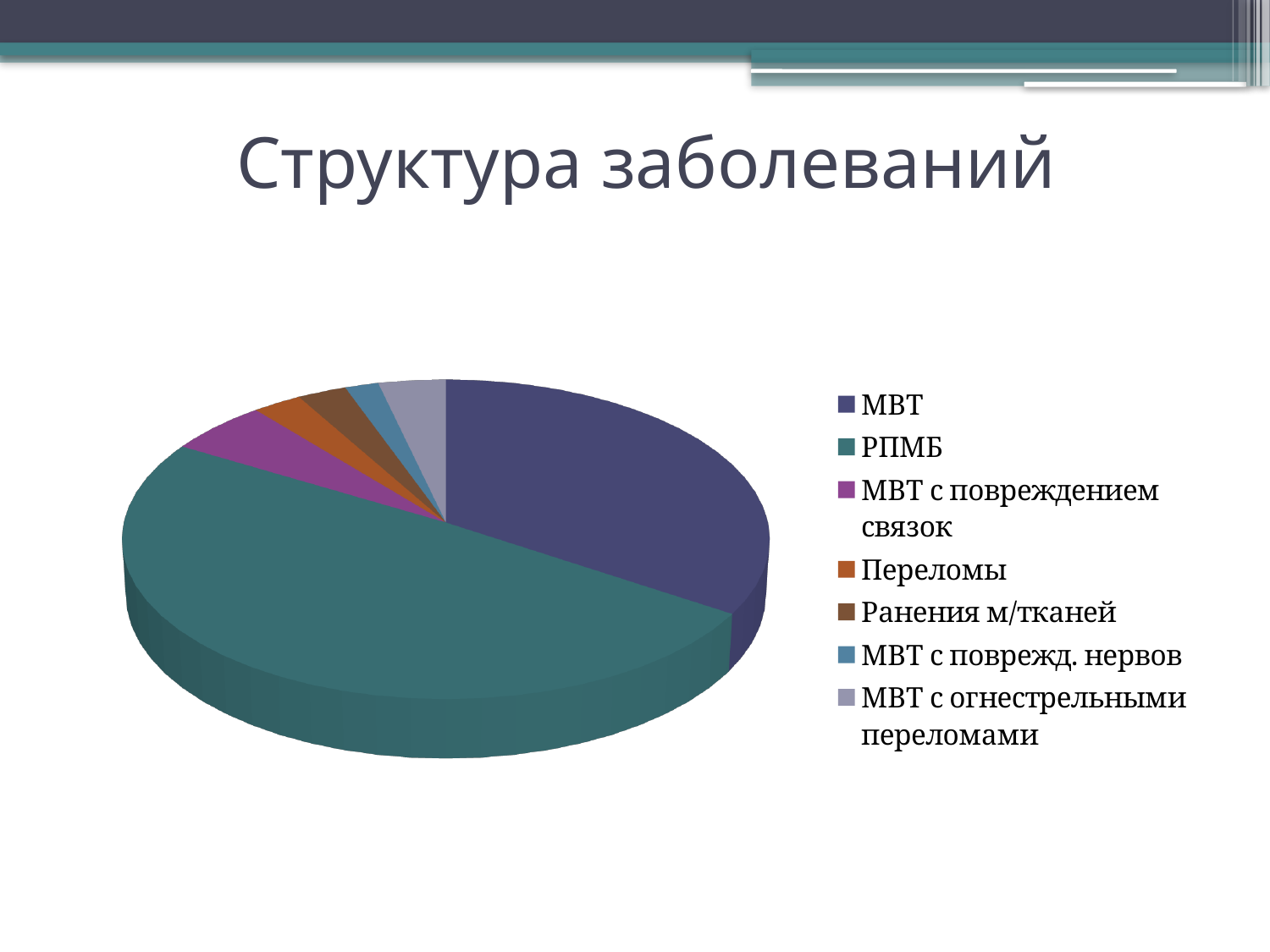
What kind of chart is shown on the slide? pie chart What is the title of the chart? Структура заболеваний Which is larger, the slice for РПМБ or the slice for МВТ с огнестрельными переломами? РПМБ Which is larger, the slice for МВТ or the slice for РПМБ? РПМБ Which is larger, the slice for МВТ с повреждением связок or the slice for МВТ? МВТ What colour is the slice for РПМБ? teal Which category has the largest slice of the pie? РПМБ Which category is listed first in the legend? МВТ How many categories does the pie chart have? 7